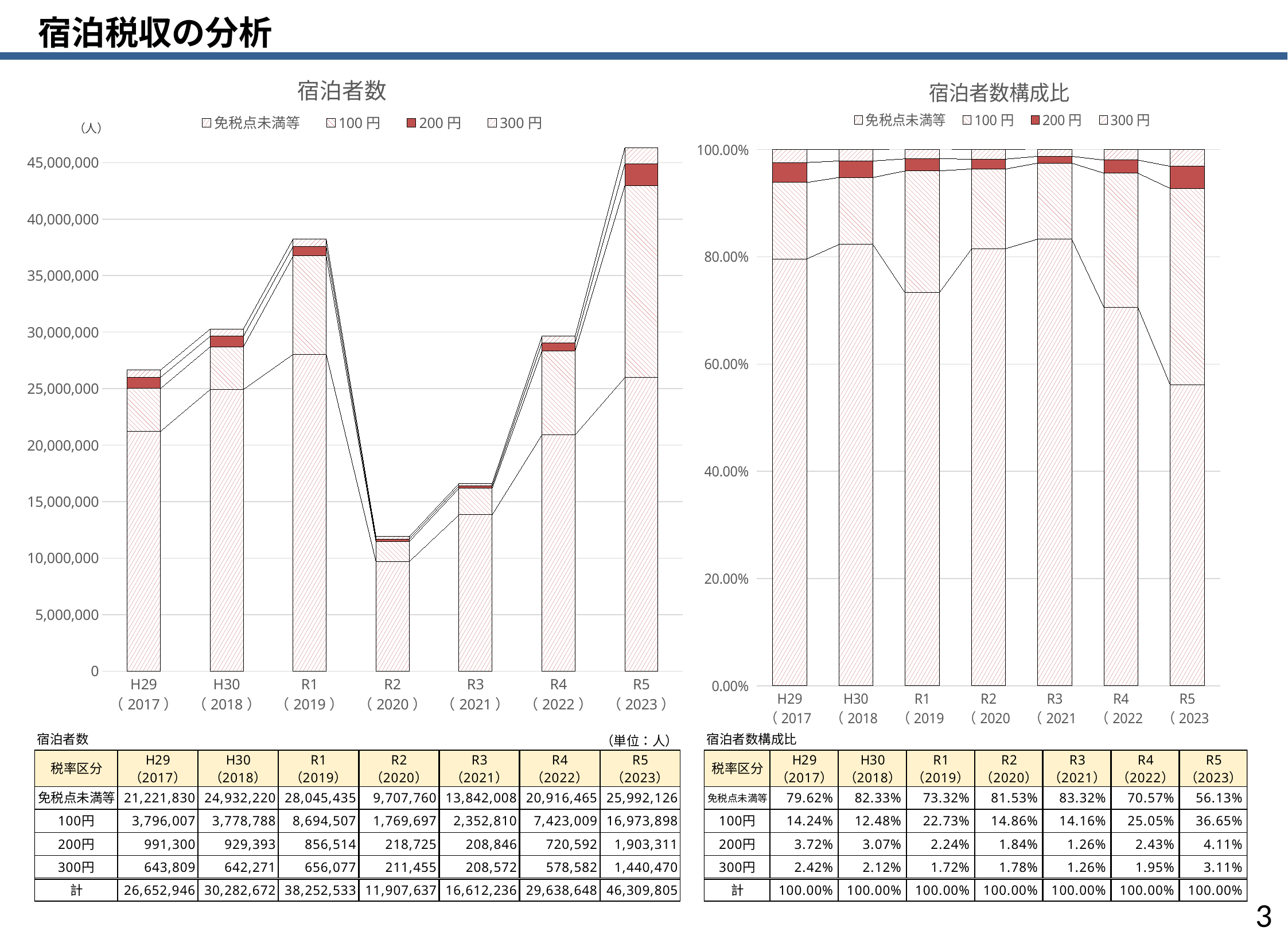
In the 宿泊者数構成比 chart, what is the share of 免税点未満等 for R5 (2023)? 56.13% In the 宿泊者数構成比 chart, which year has the highest share of 免税点未満等? R3 (2021) In the 宿泊者数 chart, which is larger, the total for H30 (2018) or the total for R4 (2022)? H30 (2018) In the 宿泊者数 chart, what is the value of the 100円 series for R5 (2023)? 16,973,898 In the 宿泊者数 chart, is the total for R3 (2021) greater or less than 20,000,000? less In the 宿泊者数構成比 chart, what is the difference between the 100円 share for R5 (2023) and for R4 (2022)? 11.60% In the 宿泊者数 chart, which year has the lowest total number of guests? R2 (2020) In the 宿泊者数 chart, how many year categories are shown on the x axis? 7 In the 宿泊者数 chart, what kind of chart is it? stacked bar chart In the 宿泊者数 chart, which year has the highest total number of guests? R5 (2023) In the 宿泊者数 chart, what is the total number of guests for R1 (2019)? 38,252,533 In the 宿泊者数 chart, how many series does the legend list? 4